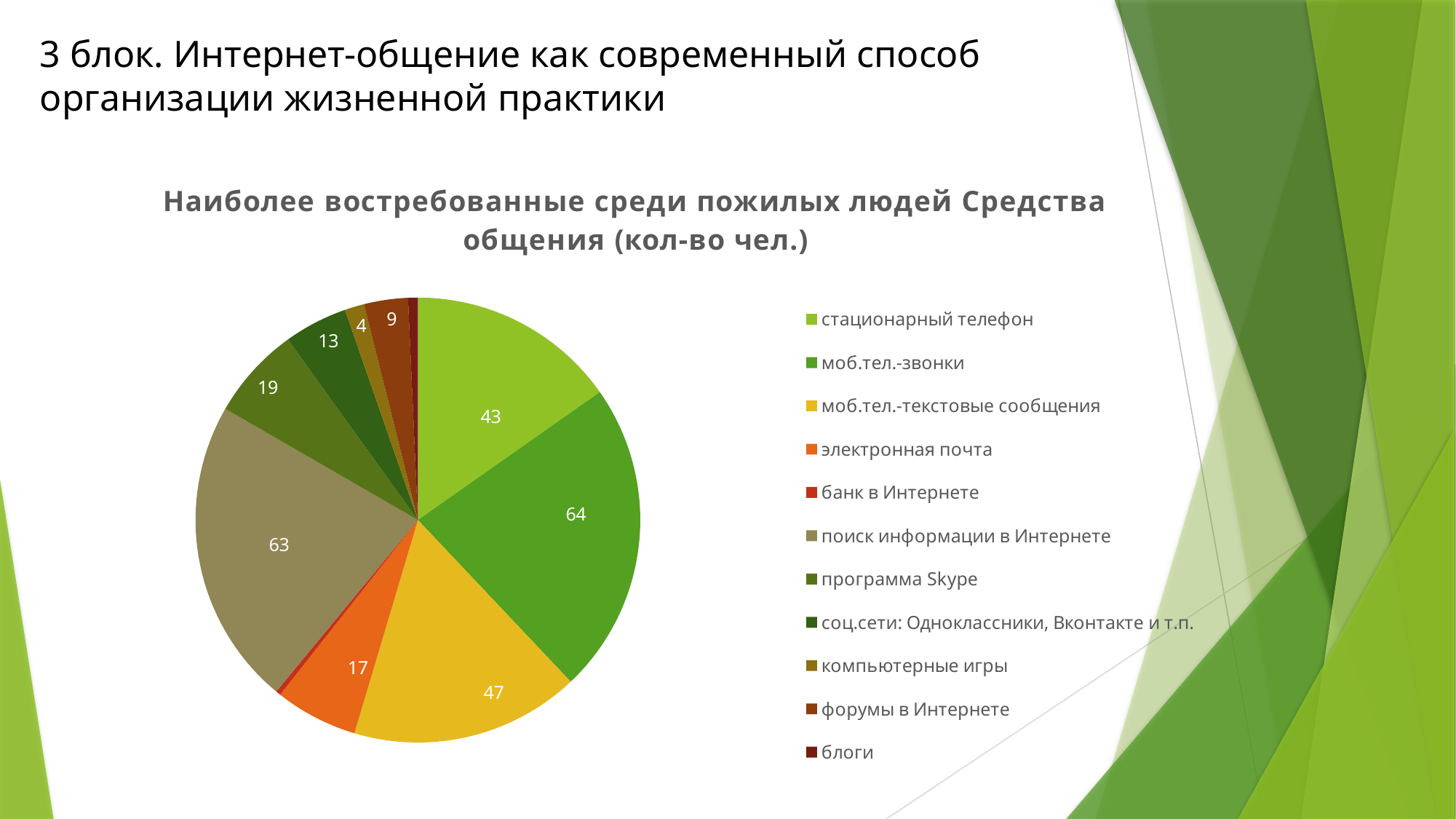
What is the difference between the values for моб.тел.-текстовые сообщения and электронная почта? 30 What is the title of the chart? Наиболее востребованные среди пожилых людей Средства общения (кол-во чел.) What is the value for компьютерные игры? 4 What is the value for моб.тел.-звонки? 64 Which is larger, the value for программа Skype or the value for соц.сети: Одноклассники, Вконтакте и т.п.? программа Skype What is the value for электронная почта? 17 What type of chart is shown on the slide? pie chart How many categories does the legend list? 11 What is the value for поиск информации в Интернете? 63 Which category has the highest value? моб.тел.-звонки What is the value for форумы в Интернете? 9 What is the value for стационарный телефон? 43